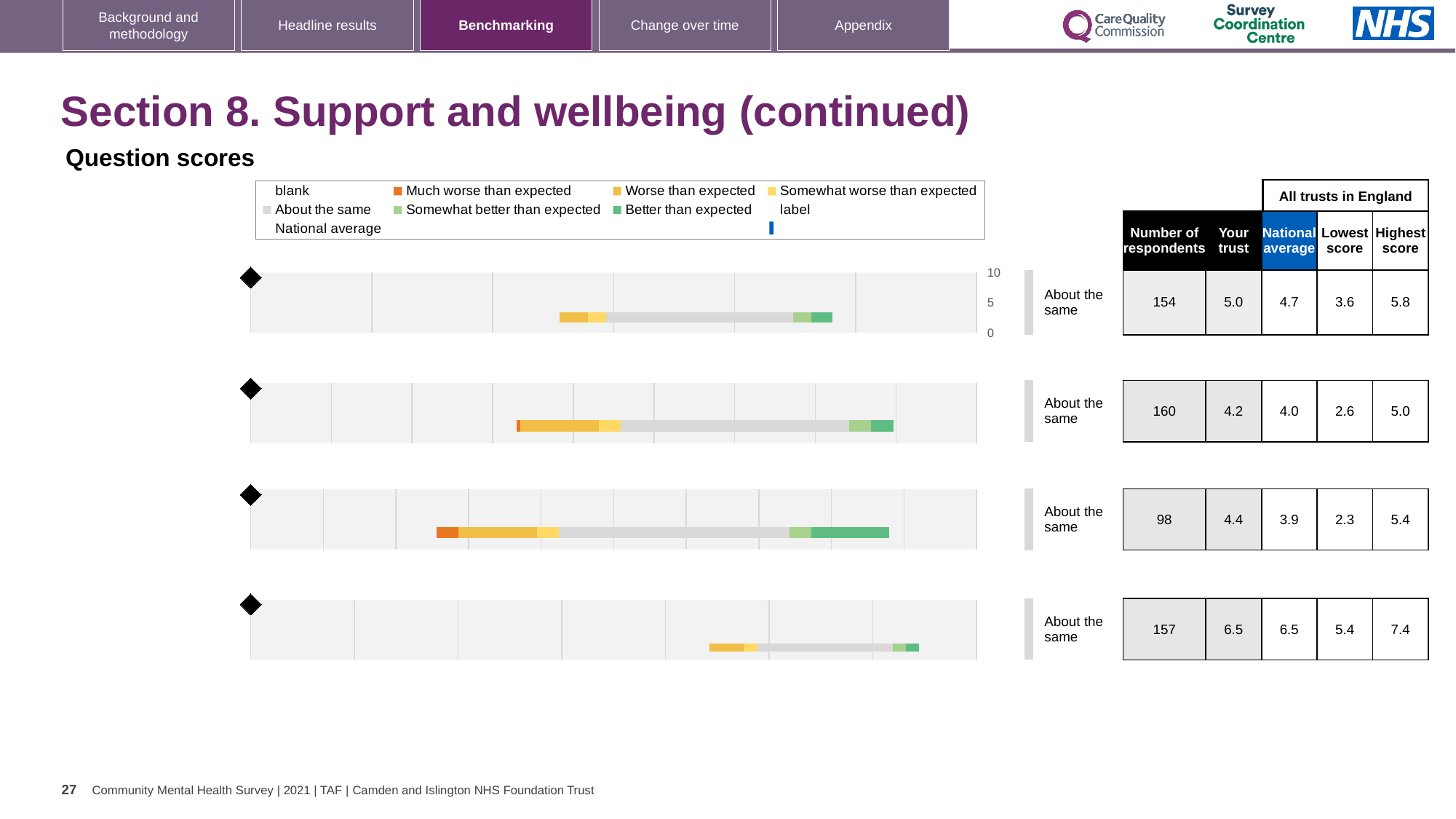
For the first (top) chart row, what is the 'Your trust' score shown in the table? 5.0 For the fourth (bottom) chart row, what is the highest score across all trusts in England? 7.4 For the third chart row, what is the lowest score across all trusts in England? 2.3 For the first (top) chart row, what is the national average shown in the table? 4.7 For the second chart row, how many respondents are shown in the table? 160 Which chart row has the highest 'Your trust' score? the fourth (bottom) row (6.5) For the first (top) chart row, what is the difference between the highest score and the lowest score? 2.2 Which chart row has the lowest number of respondents? the third row (98) For the third chart row, which is larger: the 'Your trust' score or the national average? Your trust (4.4) How many benchmarking charts are shown on the slide? 4 What kind of chart is used for the four benchmarking rows on the slide? bar chart In the legend, what colour represents 'Much worse than expected'? orange